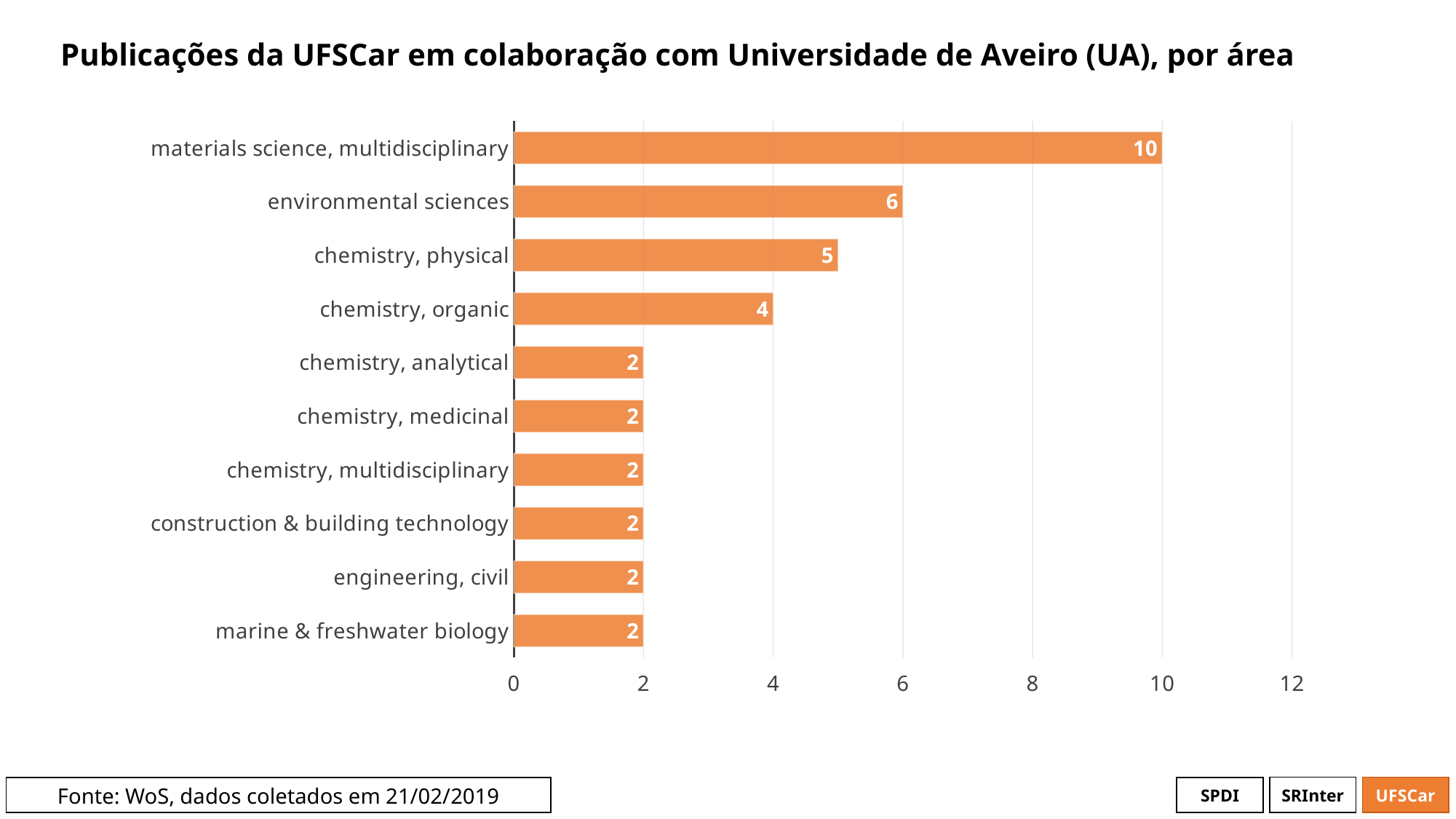
What is the value for chemistry, organic? 4 What kind of chart is shown on the slide? bar chart Which area has the highest number of publications? materials science, multidisciplinary What is the difference between the values for chemistry, physical and chemistry, organic? 1 Is the value for materials science, multidisciplinary greater or less than 8? greater What is the value for chemistry, physical? 5 Which is larger, the value for environmental sciences or the value for chemistry, physical? environmental sciences What is the value for materials science, multidisciplinary? 10 How many areas are shown in the chart? 10 What is the difference between the values for materials science, multidisciplinary and environmental sciences? 4 What is the title of the chart? Publicações da UFSCar em colaboração com Universidade de Aveiro (UA), por área What is the value for environmental sciences? 6